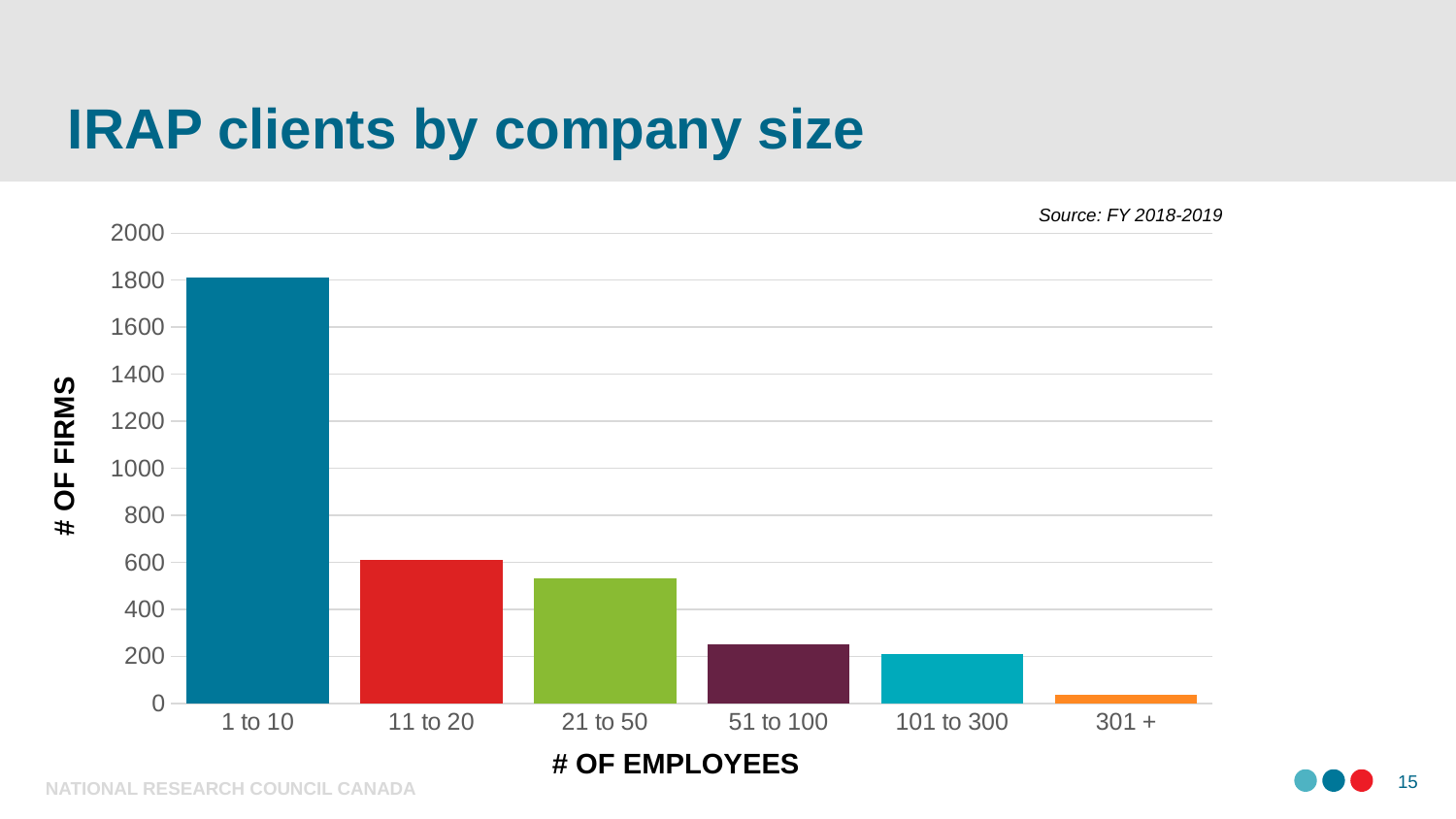
Is the number of firms for 11 to 20 employees greater or less than 800? less Which company size category has the lowest number of firms? 301 + Which has more firms: the 11 to 20 category or the 21 to 50 category? 11 to 20 How many company size categories are shown on the x axis? 6 Do the values rise or fall as company size increases along the x axis? fall Is the number of firms for 301 + employees greater or less than 200? less What kind of chart is shown on the slide? bar chart What is the label of the vertical axis? # OF FIRMS Is the number of firms for 51 to 100 employees greater or less than 400? less Which company size category has the highest number of firms? 1 to 10